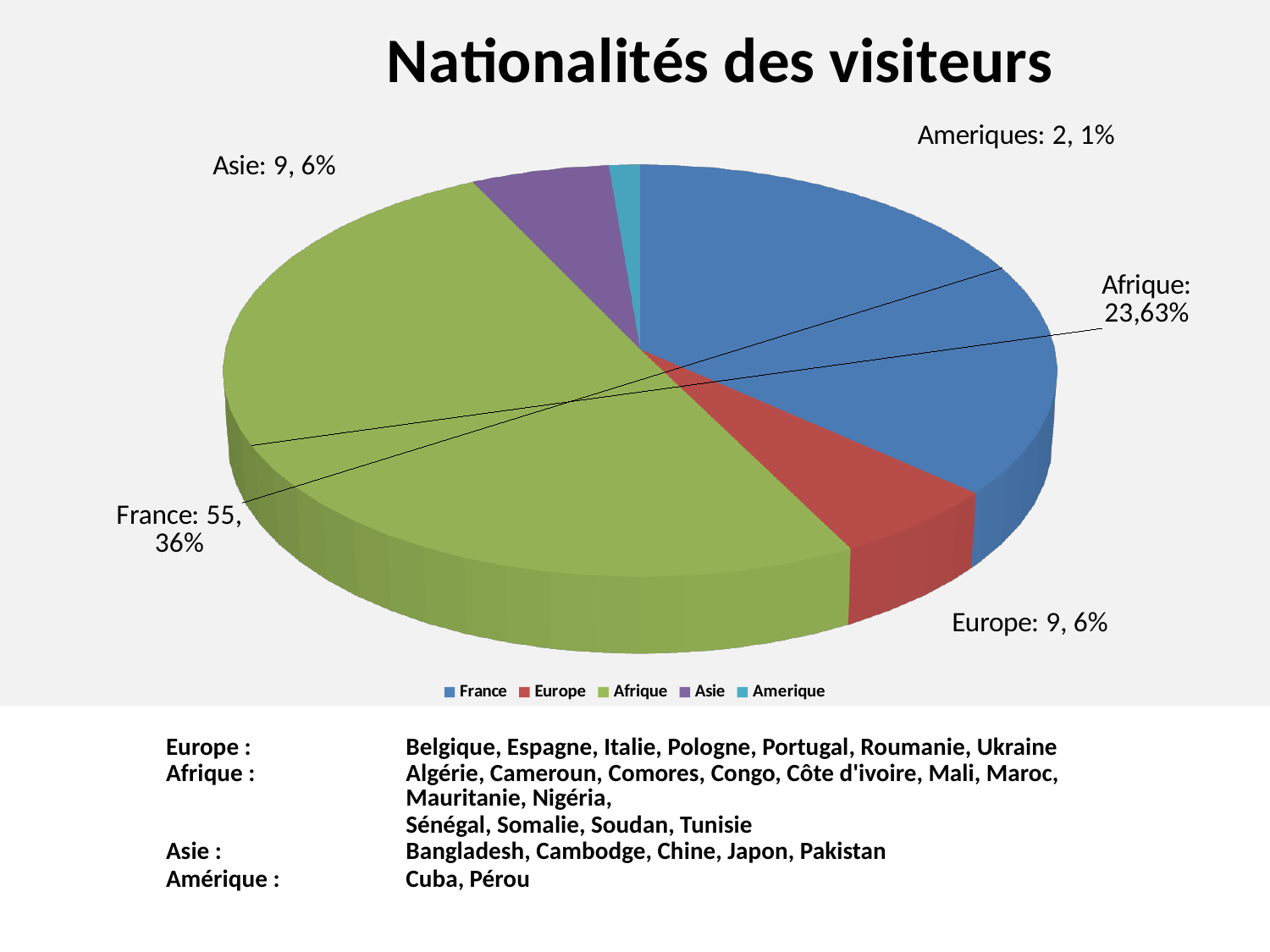
How many entries does the legend list? 5 What count is shown for Ameriques? 2 What count and percentage are shown for France? 55, 36% What is the title of the chart? Nationalités des visiteurs What kind of chart is shown on the slide? pie chart What is the difference between the count for France and the count for Europe? 46 What share of the pie does Ameriques represent? 1% What count and percentage are shown for Europe? 9, 6% What share of the pie does Asie represent? 6% How many slices does the pie chart have? 5 Which is larger, the value for Europe or the value for Ameriques? Europe Which category has the smallest slice of the pie? Ameriques